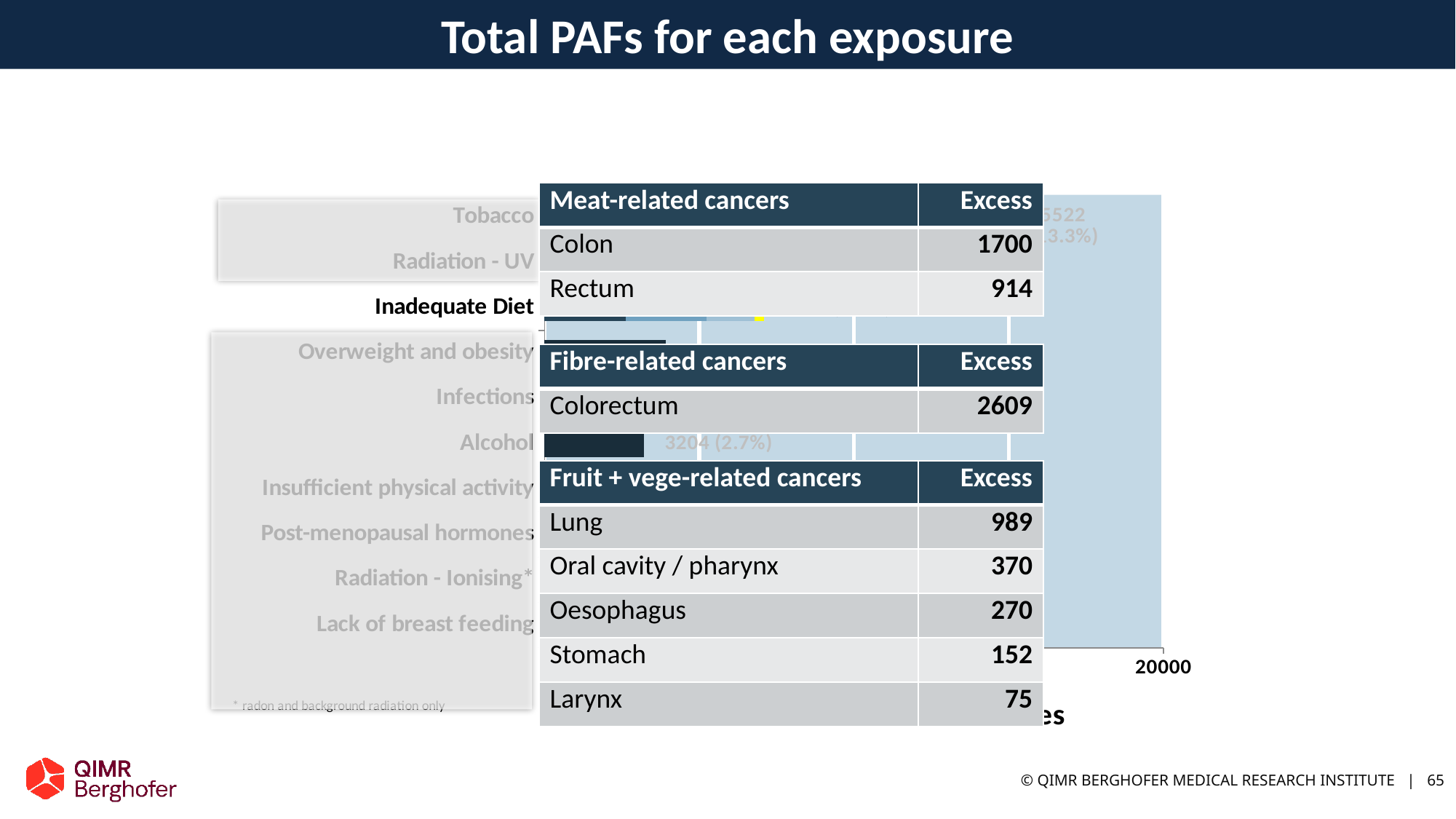
What is the data label shown on the chart for Alcohol? 3204 (2.7%) What kind of chart is shown on the slide? bar chart Which exposure category is listed last (at the bottom) of the chart's vertical axis? Lack of breast feeding Which exposure category is listed first (at the top) of the chart's vertical axis? Tobacco Which exposure category on the chart is highlighted in bold black text rather than greyed out? Inadequate Diet What is the largest axis tick value visible on the chart's horizontal axis? 20000 How many exposure categories are listed on the chart's vertical axis? 10